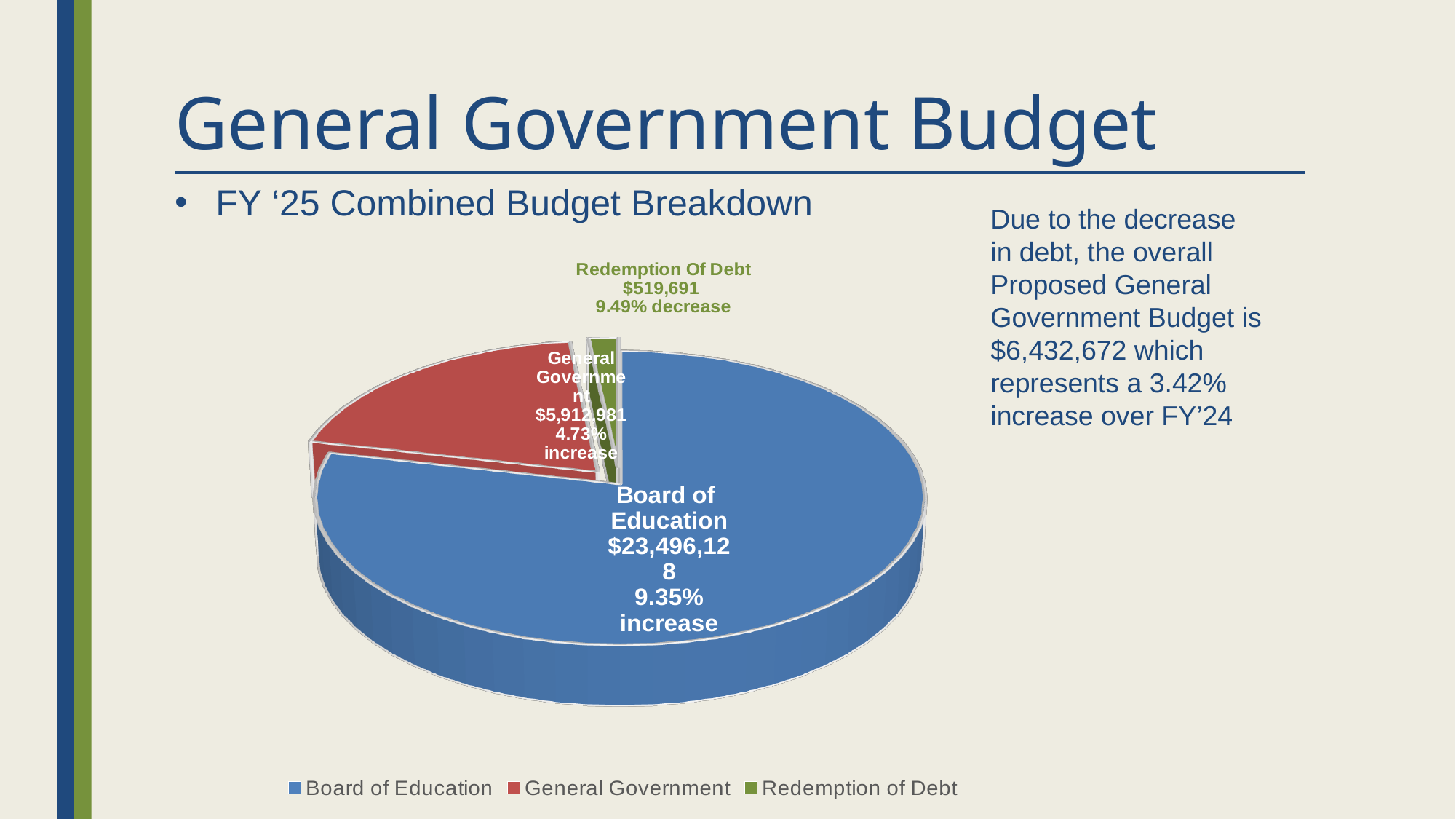
What is the value shown for Redemption of Debt in the pie chart? $519,691 Which category has the smallest slice in the pie chart? Redemption of Debt What kind of chart is shown on the slide? Pie chart What is the value shown for Board of Education in the pie chart? $23,496,128 How many slices does the pie chart have? 3 What percentage change is shown for Redemption of Debt in the pie chart? 9.49% decrease Which is larger in the pie chart, General Government or Redemption of Debt? General Government How many entries does the legend of the pie chart list? 3 What percentage change is shown for Board of Education in the pie chart? 9.35% increase What is the difference between the Board of Education value and the General Government value in the pie chart? $17,583,147 What is the value shown for General Government in the pie chart? $5,912,981 Which category has the largest slice in the pie chart? Board of Education